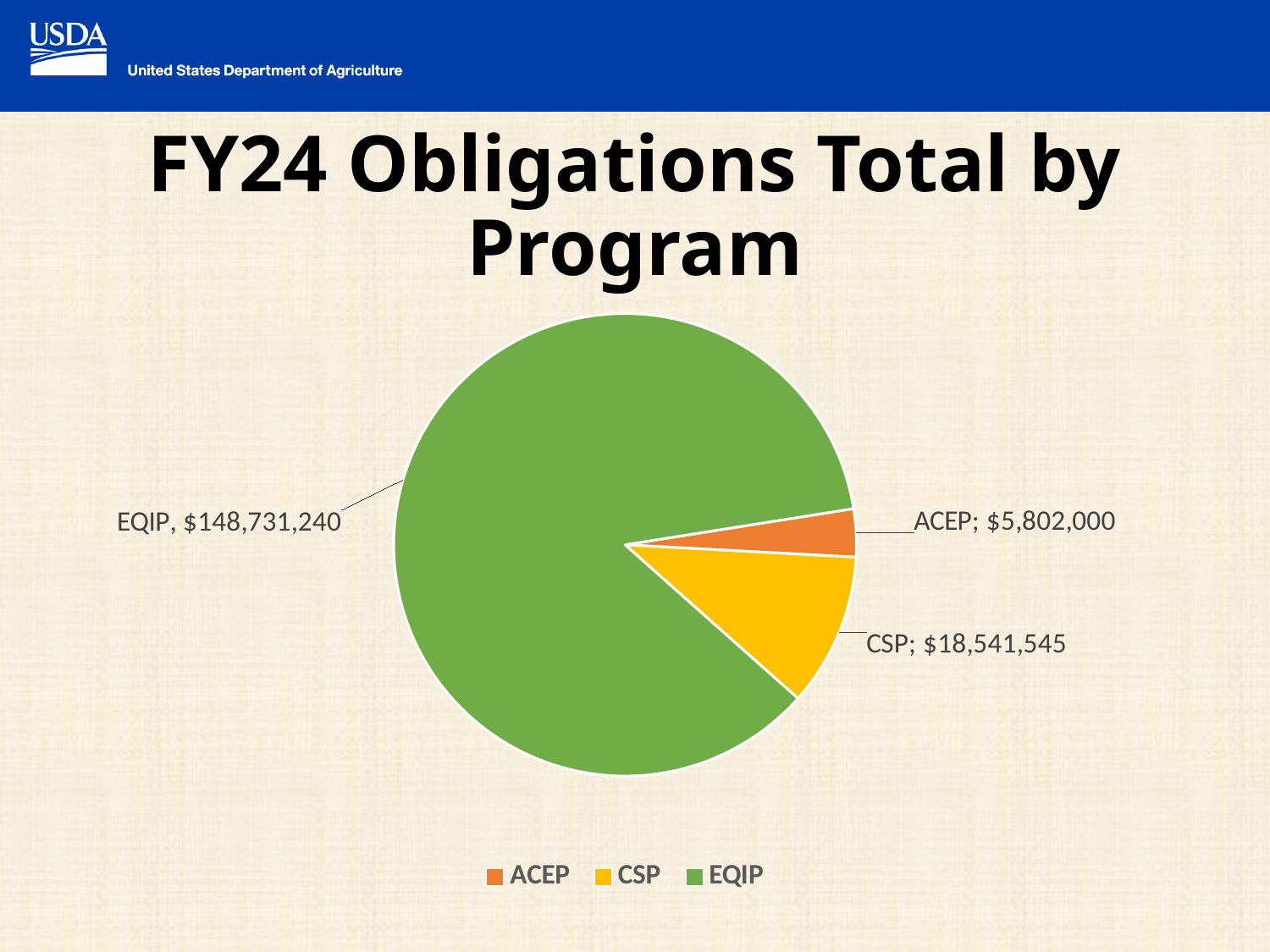
What is the difference between the CSP and ACEP obligation totals? $12,739,545 Which program has the smallest FY24 obligation total? ACEP Which program has the largest FY24 obligation total? EQIP How many entries does the legend list? 3 What is the FY24 obligation total for EQIP? $148,731,240 What is the FY24 obligation total for ACEP? $5,802,000 What type of chart is shown on the slide? Pie chart What is the FY24 obligation total for CSP? $18,541,545 What is the title of the chart? FY24 Obligations Total by Program How many programs are shown in the pie chart? 3 Which is larger, the obligation total for CSP or for ACEP? CSP What is the combined FY24 obligation total across all three programs? $173,074,785